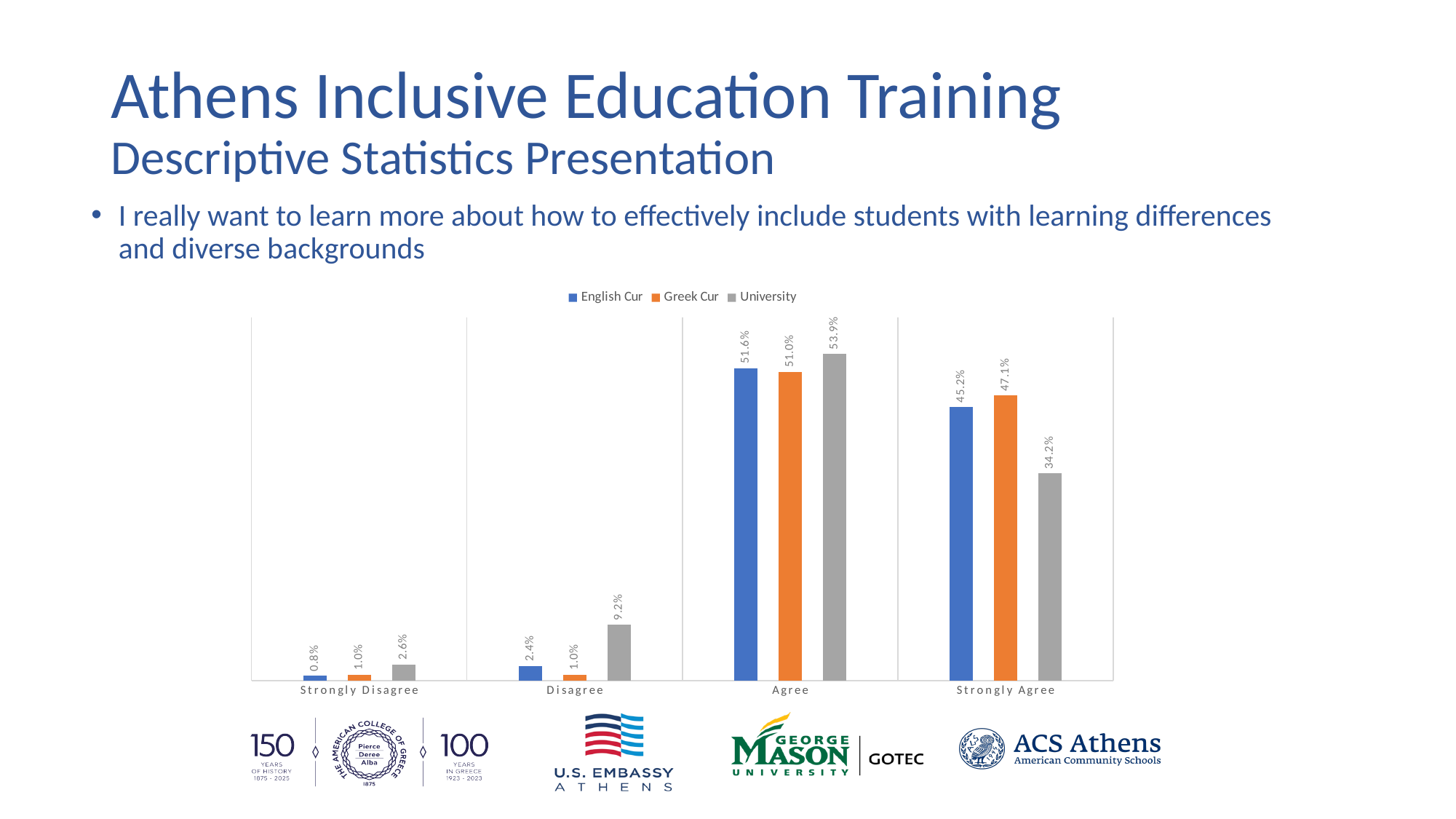
Which category has the lowest value for the English Cur series? Strongly Disagree What kind of chart is shown on the slide? Bar chart In the Disagree category, which series has the larger value: English Cur or University? University Which series is shown in orange in the legend? Greek Cur What is the value for University in the Strongly Disagree category? 2.6% How many categories are shown on the x axis? 4 What is the difference between the Greek Cur and University values in the Strongly Agree category? 12.9% What is the value for University in the Agree category? 53.9% How many series does the legend list? 3 What is the value for English Cur in the Strongly Agree category? 45.2% Which category has the highest value for the Greek Cur series? Agree What is the value for Greek Cur in the Disagree category? 1.0%